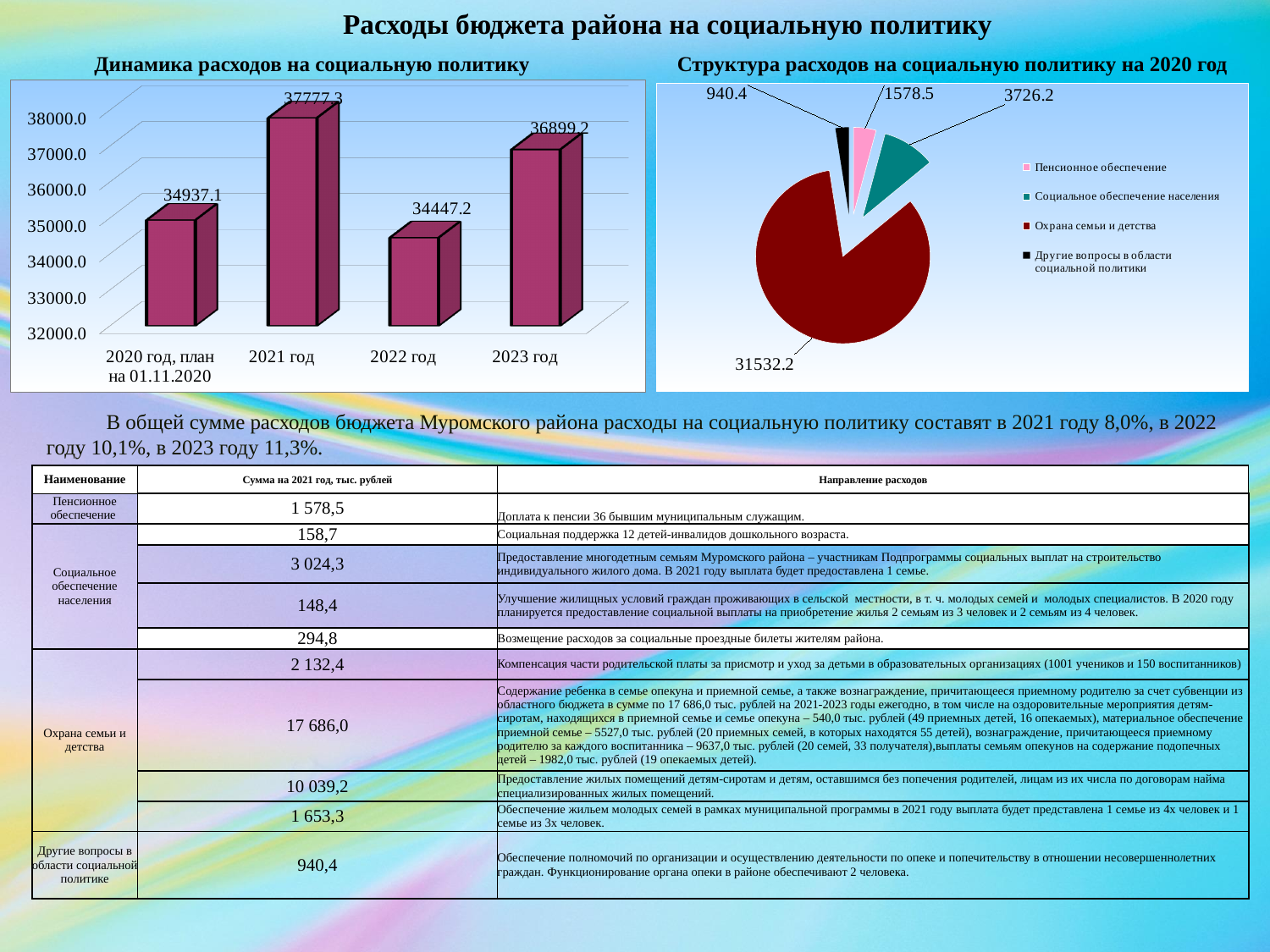
In the pie chart 'Структура расходов на социальную политику на 2020 год', what is the value for Пенсионное обеспечение? 1578.5 What type of chart is 'Динамика расходов на социальную политику'? Bar chart In the bar chart 'Динамика расходов на социальную политику', what is the value for 2023 год? 36899.2 In the bar chart 'Динамика расходов на социальную политику', which year has the highest value? 2021 год In the bar chart 'Динамика расходов на социальную политику', which category has the lowest value? 2022 год In the bar chart 'Динамика расходов на социальную политику', what is the difference between the values for 2021 год and 2022 год? 3330.1 In the pie chart 'Структура расходов на социальную политику на 2020 год', which category has the smallest slice? Другие вопросы в области социальной политики How many entries does the legend of the pie chart 'Структура расходов на социальную политику на 2020 год' list? 4 In the bar chart 'Динамика расходов на социальную политику', what is the value for 2021 год? 37777.3 In the bar chart 'Динамика расходов на социальную политику', which is larger: the value for 2020 год, план на 01.11.2020 or the value for 2023 год? 2023 год In the pie chart 'Структура расходов на социальную политику на 2020 год', what is the value for Охрана семьи и детства? 31532.2 How many categories are shown in the bar chart 'Динамика расходов на социальную политику'? 4